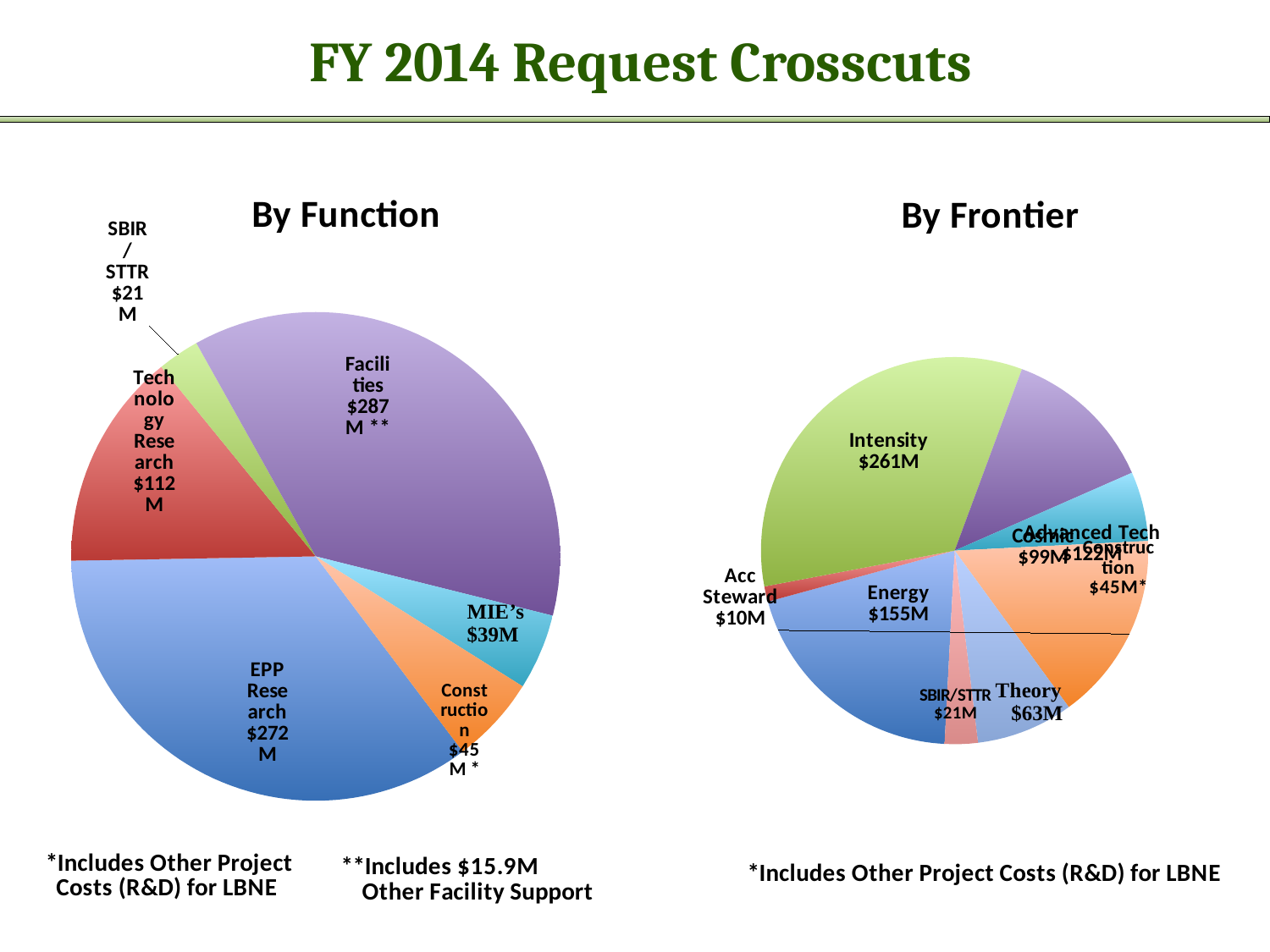
How many slices does the By Function pie chart have? 6 In the By Frontier chart, which category has the largest slice? Intensity In the By Function chart, what is the difference between Facilities and EPP Research? $15M In the By Function chart, what is the value for Facilities? $287M In the By Function chart, which is larger, Technology Research or MIE's? Technology Research In the By Frontier chart, what is the difference between Intensity and Energy? $106M In the By Function chart, which category has the smallest slice? SBIR/STTR In the By Frontier chart, what is the value for Intensity? $261M In the By Frontier chart, what is the value for Energy? $155M In the By Function chart, which category has the largest slice? Facilities What kind of chart is the By Frontier chart? Pie chart In the By Frontier chart, which category has the smallest slice? Acc Steward